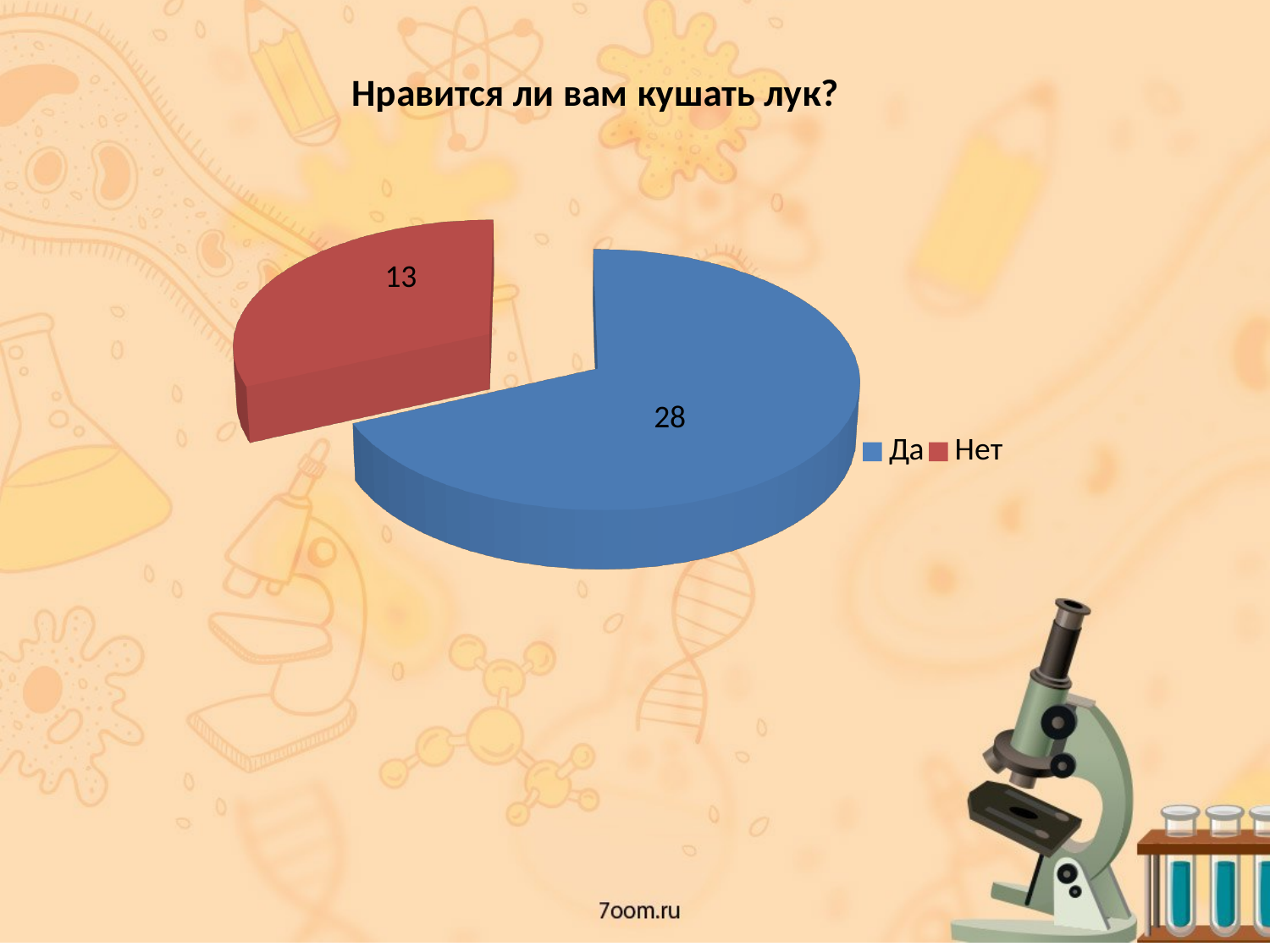
What is the value of the "Да" slice in the pie chart? 28 What is the difference between the "Да" and "Нет" values? 15 What is the title of the chart? Нравится ли вам кушать лук? How many entries does the legend list? 2 What is the total of all slices in the pie chart? 41 Which category has the smallest slice in the pie chart? Нет Which category has the largest slice in the pie chart? Да Which is larger, the value for "Да" or the value for "Нет"? Да What colour is the "Нет" slice in the pie chart? Red How many slices does the pie chart have? 2 What is the value of the "Нет" slice in the pie chart? 13 What type of chart is shown on the slide? Pie chart